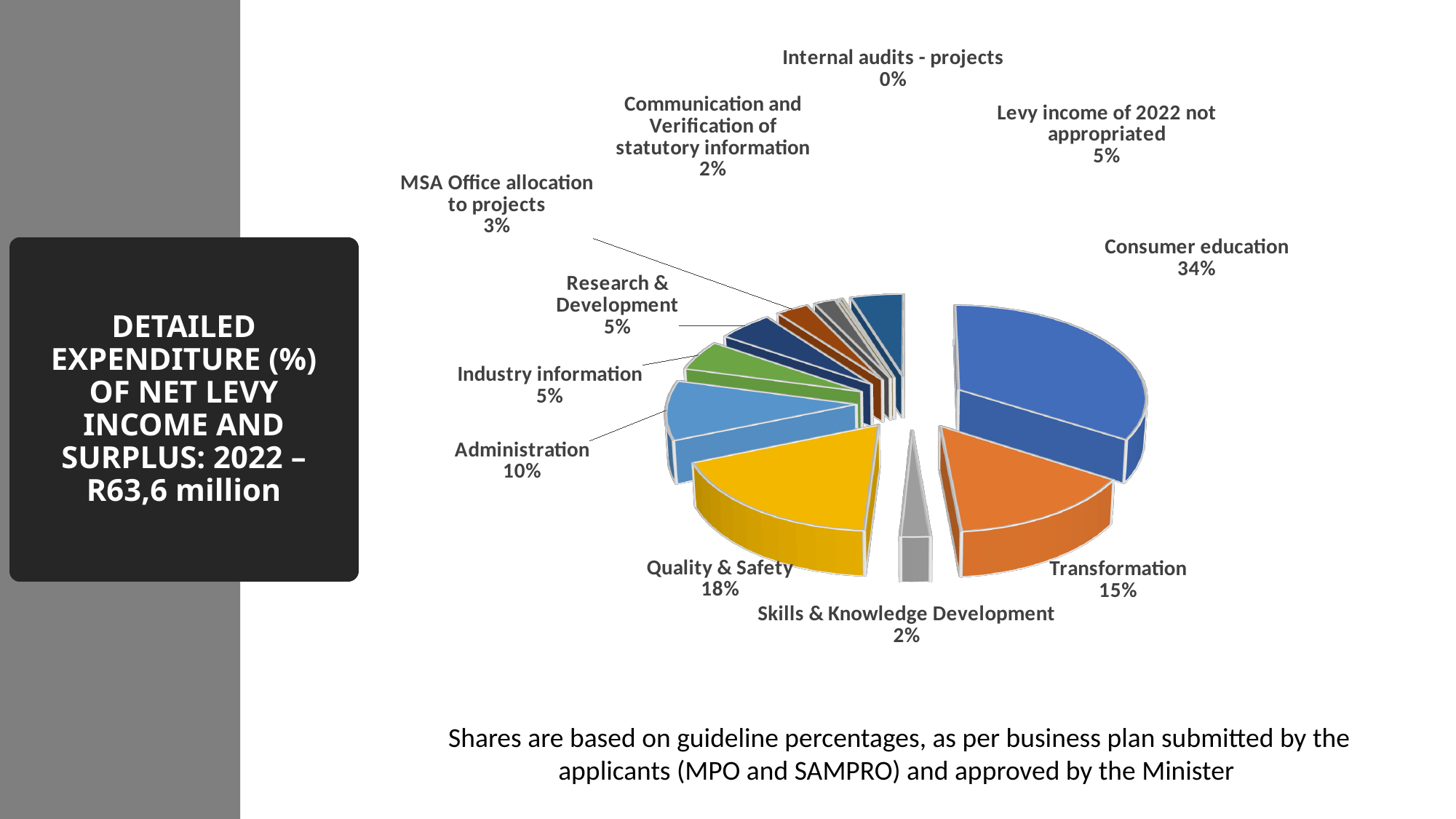
What percentage is shown for Administration? 10% Which category has the smallest share of the pie? Internal audits - projects What is the difference in percentage points between Consumer education and Transformation? 19 Which is larger, the share for Quality & Safety or the share for Transformation? Quality & Safety What percentage is shown for Quality & Safety? 18% How many categories are shown in the pie chart? 11 What percentage is shown for Internal audits - projects? 0% Which category has the largest share of the pie? Consumer education What type of chart is shown on the slide? Pie chart What share of the pie does Consumer education represent? 34% What total amount is stated in the slide title for the 2022 net levy income and surplus? R63,6 million What percentage is shown for MSA Office allocation to projects? 3%